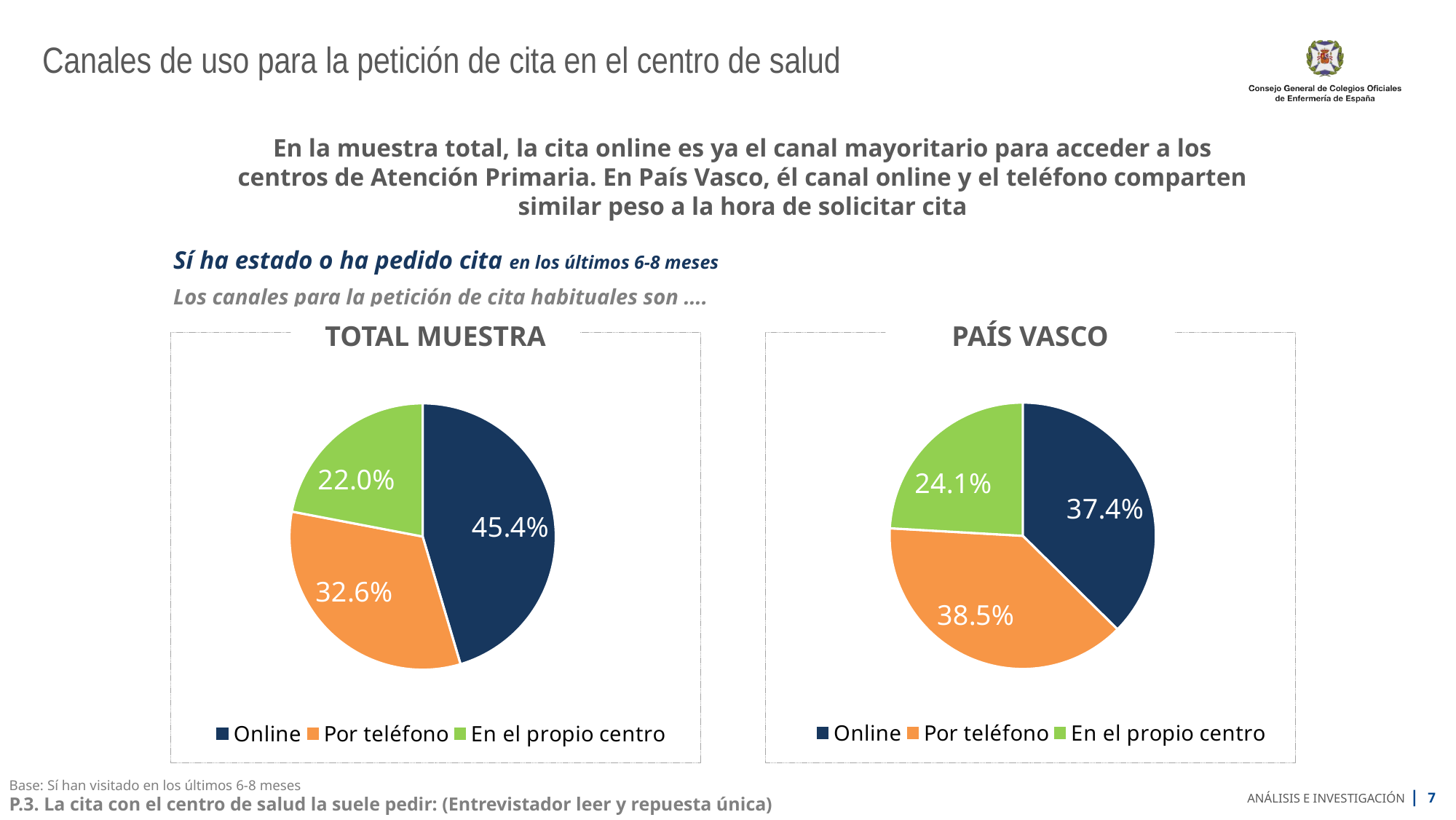
In the TOTAL MUESTRA pie chart, what is the difference in percentage points between Online and En el propio centro? 23.4 What type of chart is used for TOTAL MUESTRA? Pie chart In the TOTAL MUESTRA pie chart, which channel has the largest share? Online In the TOTAL MUESTRA pie chart, what percentage is shown for Online? 45.4% In the TOTAL MUESTRA chart legend, which colour represents Por teléfono? Orange In the PAÍS VASCO pie chart, what percentage is shown for En el propio centro? 24.1% In the PAÍS VASCO pie chart, which channel has the smallest share? En el propio centro Is the Online share larger in the TOTAL MUESTRA chart or in the PAÍS VASCO chart? TOTAL MUESTRA How many slices does the PAÍS VASCO pie chart have? 3 In the PAÍS VASCO pie chart, what percentage is shown for Por teléfono? 38.5% In the TOTAL MUESTRA pie chart, what percentage is shown for Por teléfono? 32.6% In the PAÍS VASCO pie chart, what is the difference in percentage points between Por teléfono and Online? 1.1